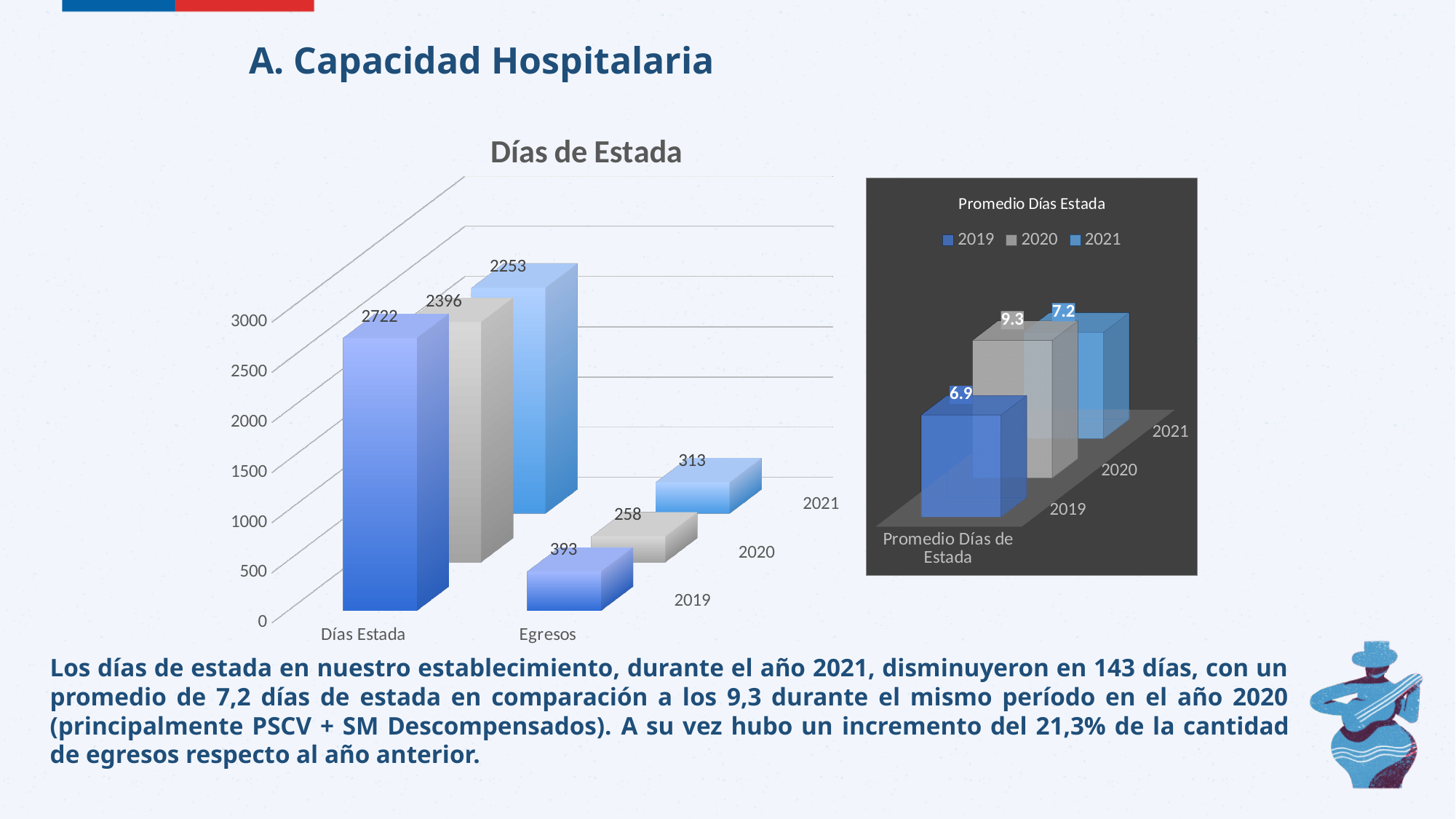
In the 'Días de Estada' chart, is the value for Egresos in 2019 larger or smaller than the value for Egresos in 2021? larger In the 'Promedio Días Estada' chart, what is the value for 2020? 9.3 In the 'Promedio Días Estada' chart, which year has the lowest value? 2019 What kind of chart is the 'Días de Estada' chart? bar chart In the 'Días de Estada' chart, what is the value for Días Estada in 2021? 2253 In the 'Promedio Días Estada' chart, what is the difference between the 2020 and 2021 values? 2.1 In the 'Días de Estada' chart, what is the difference between Días Estada in 2020 and in 2021? 143 In the 'Días de Estada' chart, which year has the highest value for Días Estada? 2019 How many series does the legend of the 'Promedio Días Estada' chart list? 3 In the 'Días de Estada' chart, what is the value for Días Estada in 2019? 2722 In the 'Días de Estada' chart, what is the value for Egresos in 2021? 313 In the 'Días de Estada' chart, which year has the lowest value for Egresos? 2020